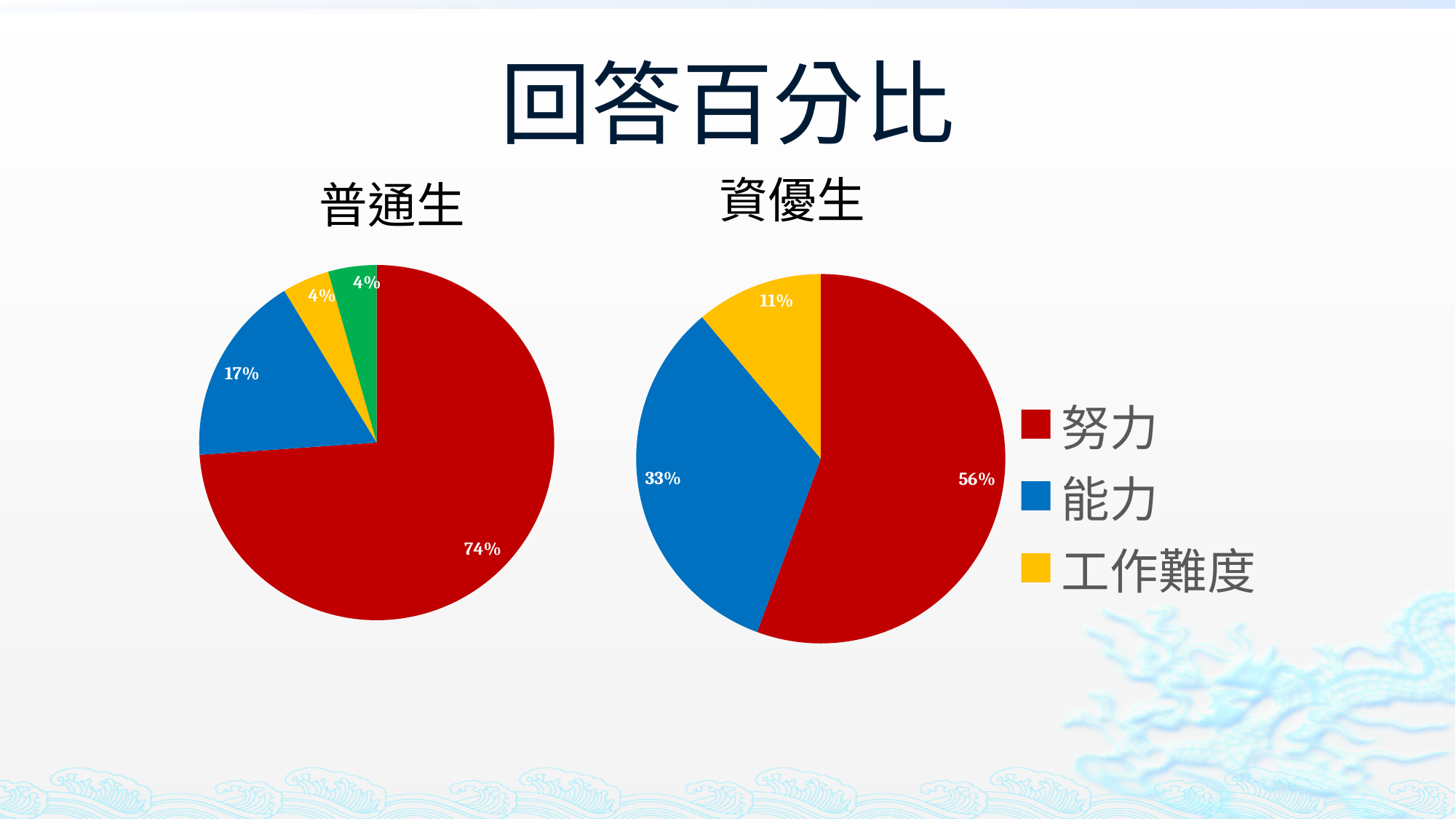
What is the difference between the 努力 share in the 普通生 chart and the 努力 share in the 資優生 chart? 18% In the 普通生 pie chart, what share does 努力 have? 74% In the 資優生 pie chart, what share does 能力 have? 33% In the 普通生 pie chart, which category has the largest slice? 努力 What kind of charts are shown on the slide? Pie charts Which chart has the larger 能力 share, 普通生 or 資優生? 資優生 In the 資優生 pie chart, which category has the largest slice? 努力 In the 普通生 pie chart, what share does 能力 have? 17% How many entries does the legend list? 3 In the 資優生 pie chart, what share does 努力 have? 56%